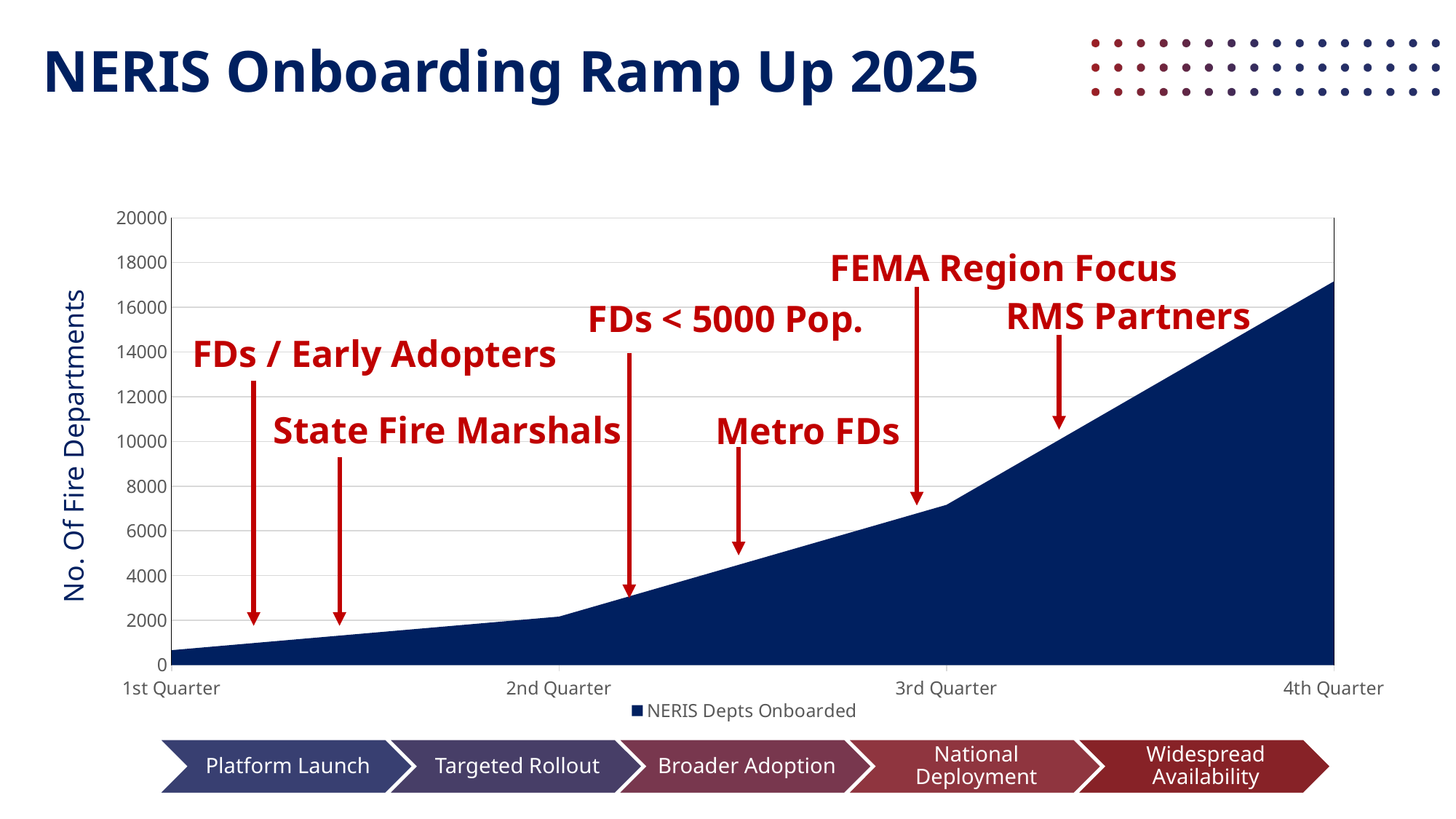
What is the name of the series shown in the chart's legend? NERIS Depts Onboarded Which quarter has the highest number of NERIS departments onboarded? 4th Quarter What is the label of the vertical axis of the chart? No. Of Fire Departments Is the value for the 4th Quarter greater or less than 16000? greater Which quarter has the lowest number of NERIS departments onboarded? 1st Quarter What kind of chart is shown on the slide? Area chart Is the value for the 2nd Quarter greater or less than 4000? less Is the value for the 3rd Quarter greater or less than 8000? less Do the values of NERIS Depts Onboarded rise or fall from the 1st Quarter to the 4th Quarter? Rise How many series does the chart's legend list? 1 Which is larger, the value for the 3rd Quarter or the value for the 2nd Quarter? 3rd Quarter How many quarters are shown on the x axis of the chart? 4